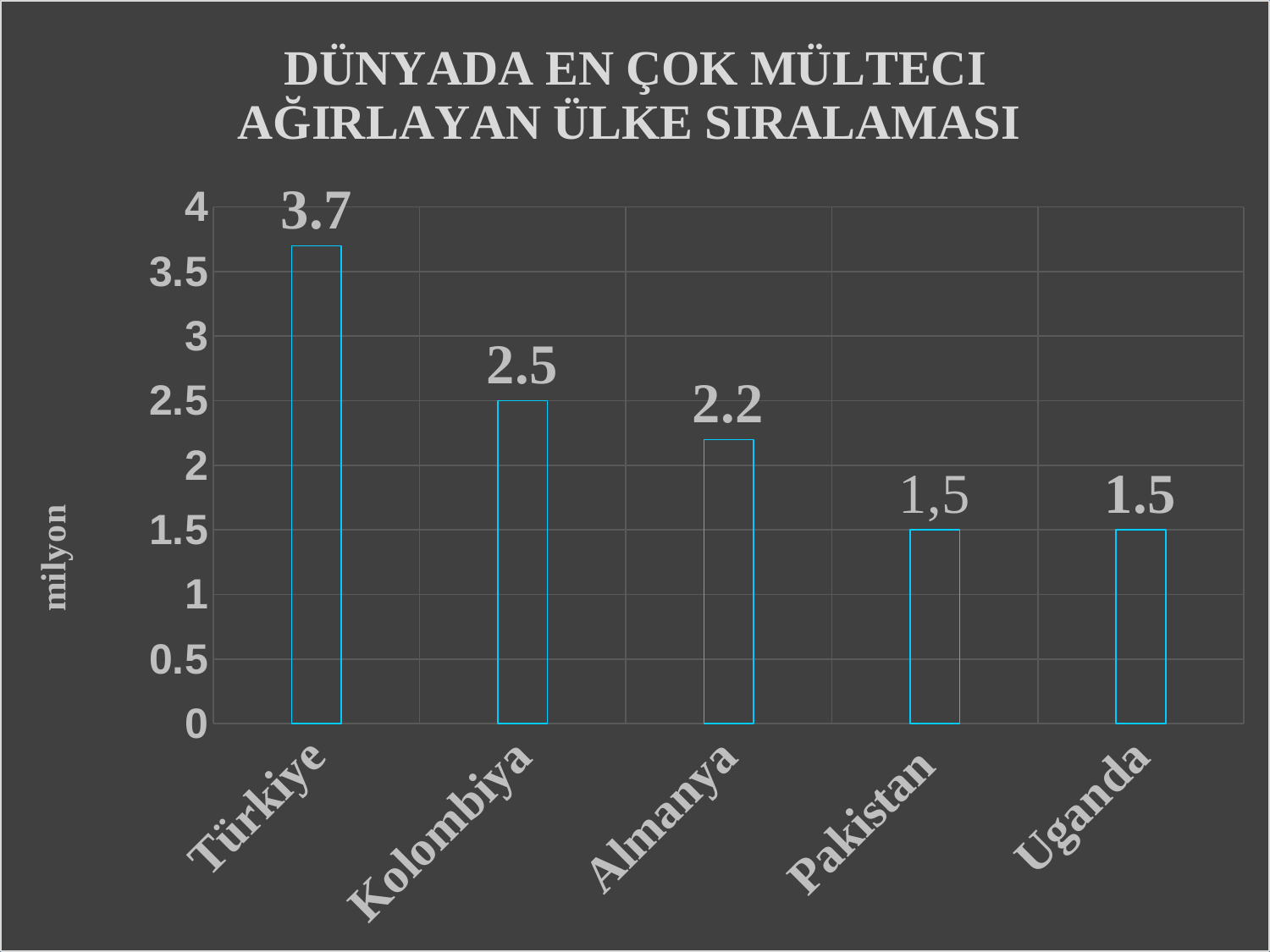
What is the value for Almanya? 2.2 What is the difference between the values for Türkiye and Kolombiya? 1.2 What is the value for Kolombiya? 2.5 What is the difference between the values for Kolombiya and Almanya? 0.3 What unit is shown on the vertical axis label? milyon What is the value for Uganda? 1.5 Which is larger, the value for Almanya or the value for Uganda? Almanya How many countries are shown on the chart? 5 What value is labelled on the bar for Pakistan? 1,5 What is the value for Türkiye? 3.7 What kind of chart is this? Bar chart Which country has the highest value? Türkiye